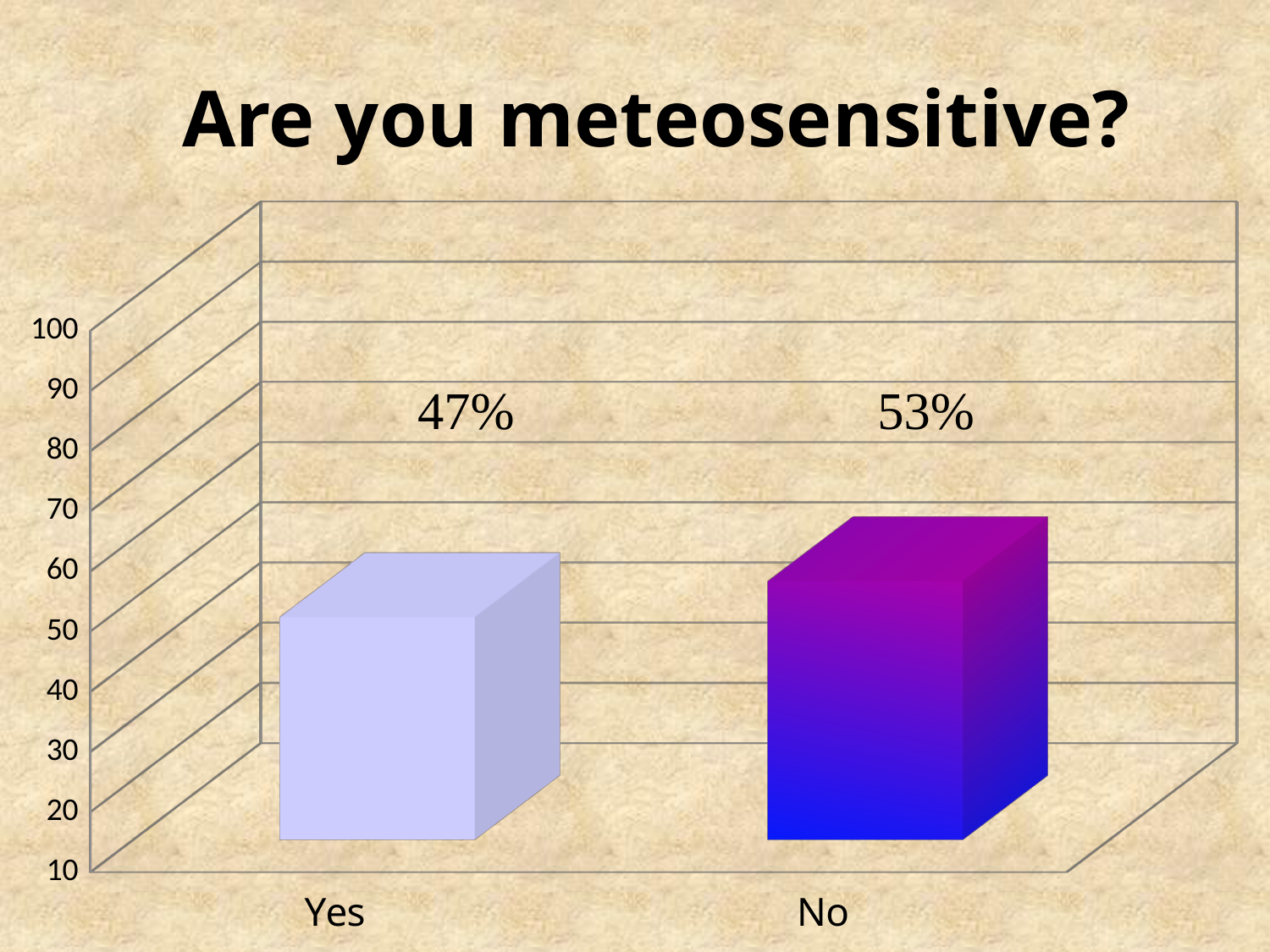
Which category has the highest value? No Is the value for No greater or less than 50? greater What is the value for Yes? 47% What is the value for No? 53% Is the value for Yes greater or less than 60? less Which is larger, the value for Yes or the value for No? No What kind of chart is shown on the slide? bar chart What is the title of the slide? Are you meteosensitive? How many categories are shown on the chart? 2 What is the highest value shown on the vertical axis? 100 Which category has the lowest value? Yes What is the difference between the values for No and Yes? 6%